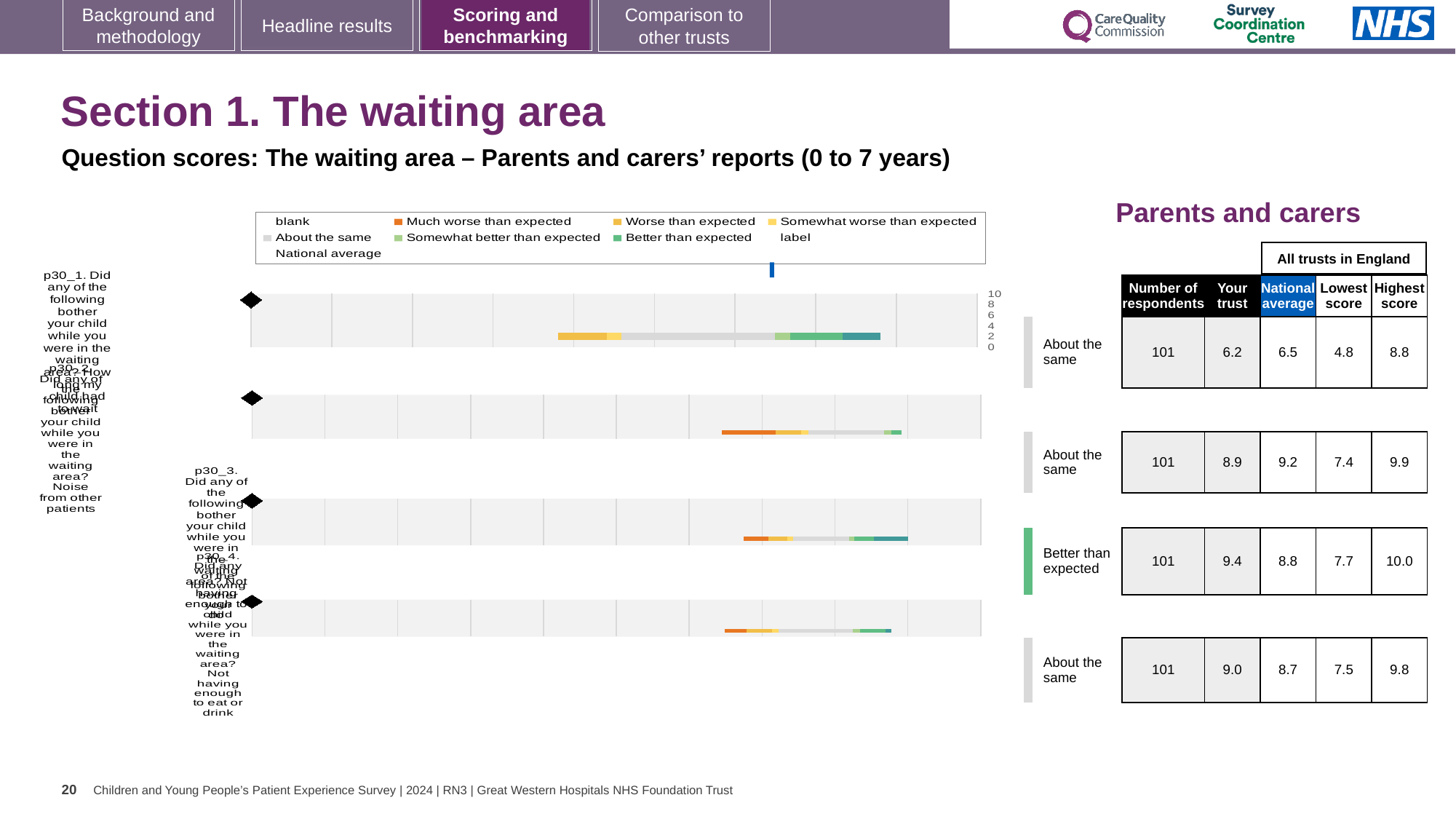
For the first question (p30_1), what is the difference between the national average and the 'Your trust' score? 0.3 In the table beside the chart, what is the national average for the second question (p30_2)? 9.2 For the third question (p30_3), which is larger: the 'Your trust' score or the national average? Your trust (9.4) Which question row has the highest 'Your trust' score in the table beside the chart? The third row (p30_3), 9.4 How many questions (bars) are plotted in the chart? 4 How many entries does the chart legend list? 9 Which question row has the lowest 'Your trust' score in the table beside the chart? The first row (p30_1), 6.2 Which question row is rated 'Better than expected' in the table beside the chart? The third row (p30_3) What kind of chart is shown on the slide? Bar chart How many respondents are listed for each question in the table beside the chart? 101 In the table beside the chart, what is the 'Your trust' score for the first question (p30_1)? 6.2 What is the subtitle describing the chart's question scores? Question scores: The waiting area – Parents and carers' reports (0 to 7 years)